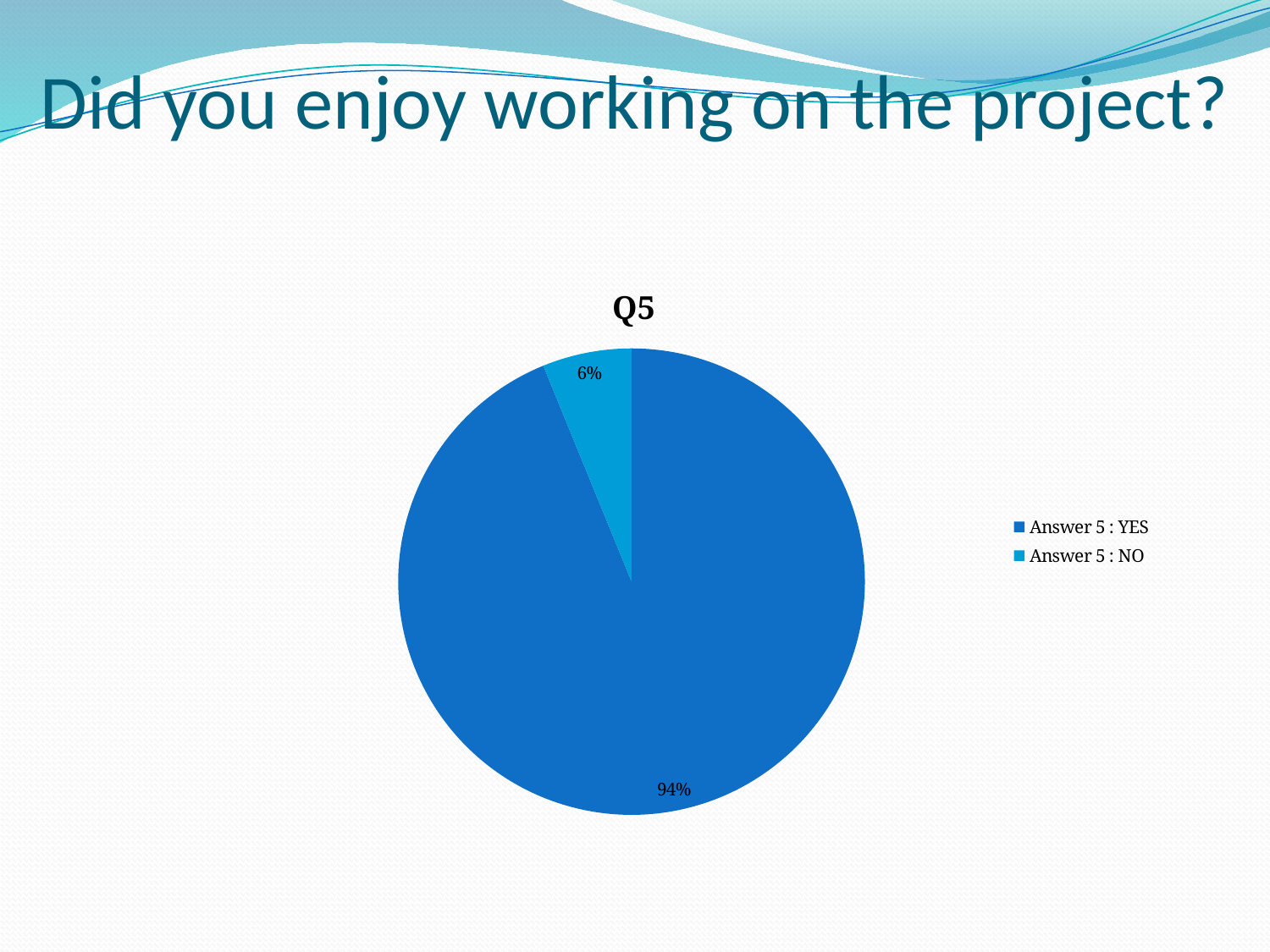
Which slice is the largest? Answer 5 : YES What share of the pie does "Answer 5 : YES" take? 94% What is the label of the slice shown in the lighter blue colour? Answer 5 : NO Which slice is the smallest? Answer 5 : NO Which is larger, the YES slice or the NO slice? Answer 5 : YES What is the chart's title? Q5 How many slices does the pie chart have? 2 What is the difference in percentage points between the YES and NO slices? 88 What share of the pie does "Answer 5 : NO" take? 6% What is the total of the two slice percentages? 100% What kind of chart is shown on the slide? pie chart How many entries does the legend list? 2